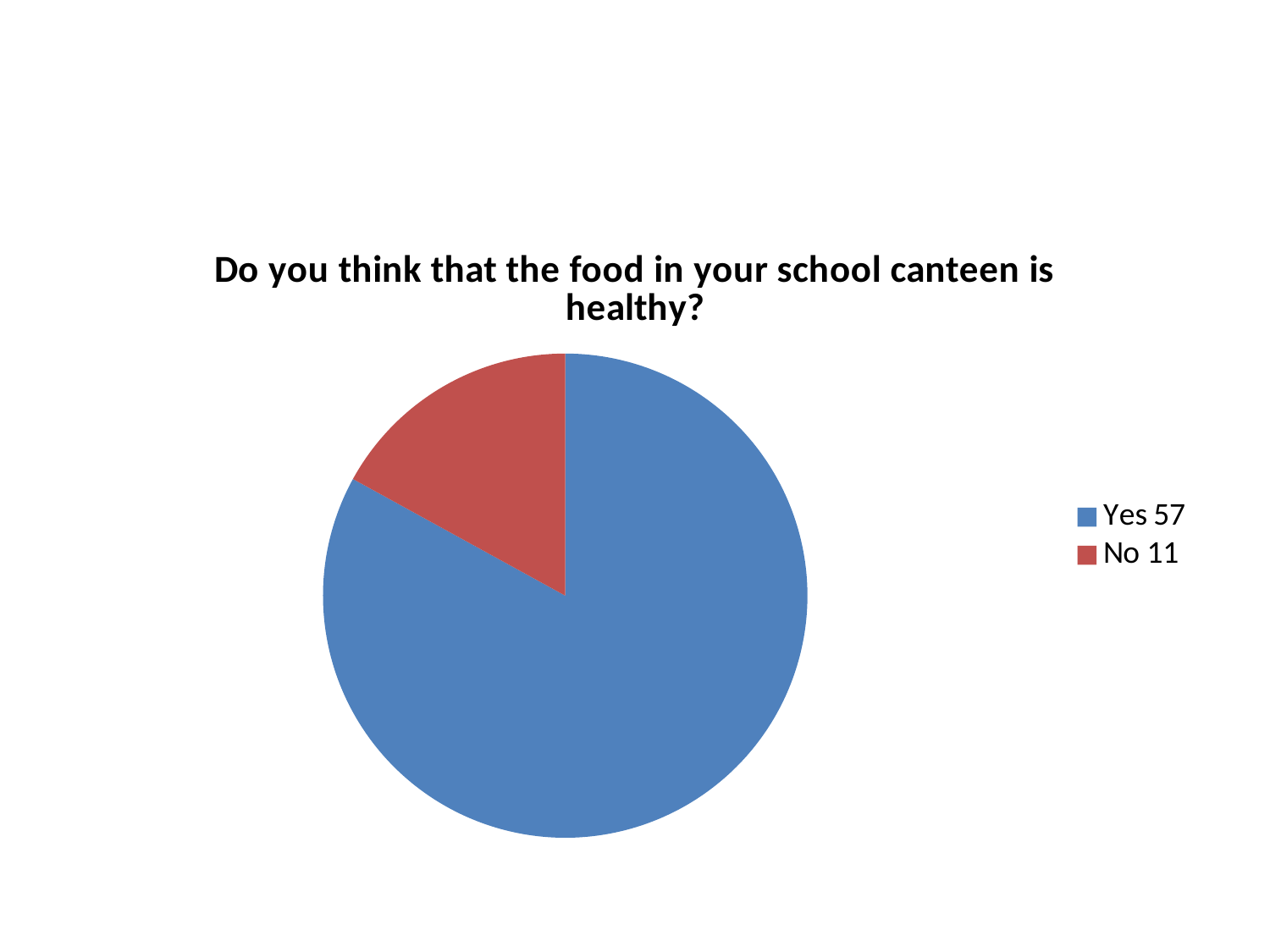
What is the value for Yes? 57 What is the difference between the Yes and No values? 46 What is the value for No? 11 What kind of chart is shown on the slide? pie chart Which is larger, Yes or No? Yes How many entries does the legend list? 2 Which response has the largest slice? Yes What is the title of the chart? Do you think that the food in your school canteen is healthy? Which response has the smallest slice? No What is the total of the Yes and No values? 68 How many slices does the pie chart have? 2 What colour is the Yes slice? blue